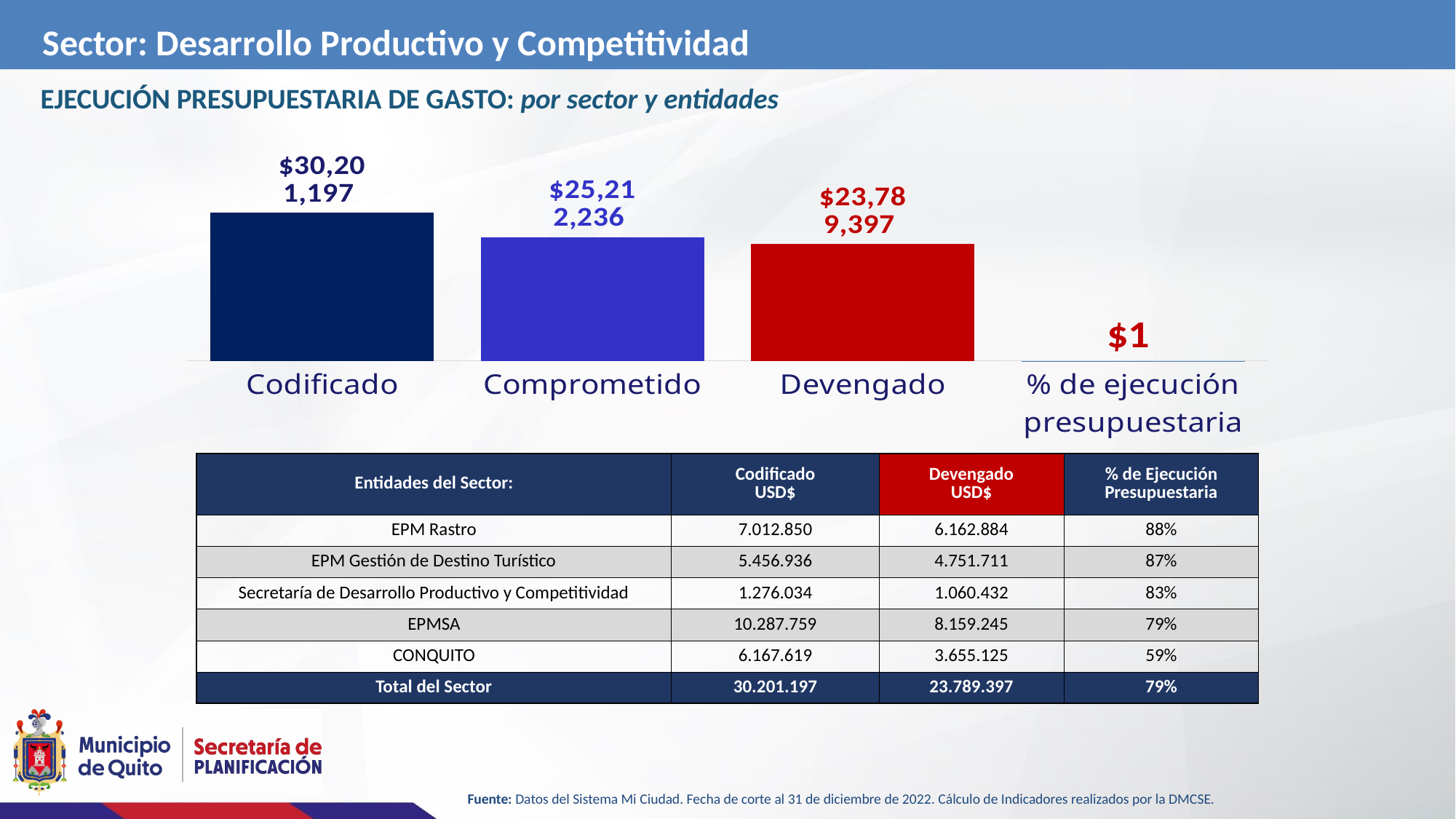
What kind of chart is shown on the slide? bar chart What is the value shown for Comprometido in the bar chart? $25,212,236 What colour is the Codificado bar in the chart? dark navy blue Which category has the lowest value in the bar chart? % de ejecución presupuestaria What colour is the Devengado bar in the chart? red Do the bar values rise or fall from Codificado to Devengado along the x axis? fall What label is printed above the '% de ejecución presupuestaria' category in the bar chart? $1 Which category has the tallest bar in the chart? Codificado Which is larger in the bar chart, Comprometido or Devengado? Comprometido How many categories are shown on the x axis of the bar chart? 4 What is the value shown for Codificado in the bar chart? $30,201,197 What is the value shown for Devengado in the bar chart? $23,789,397